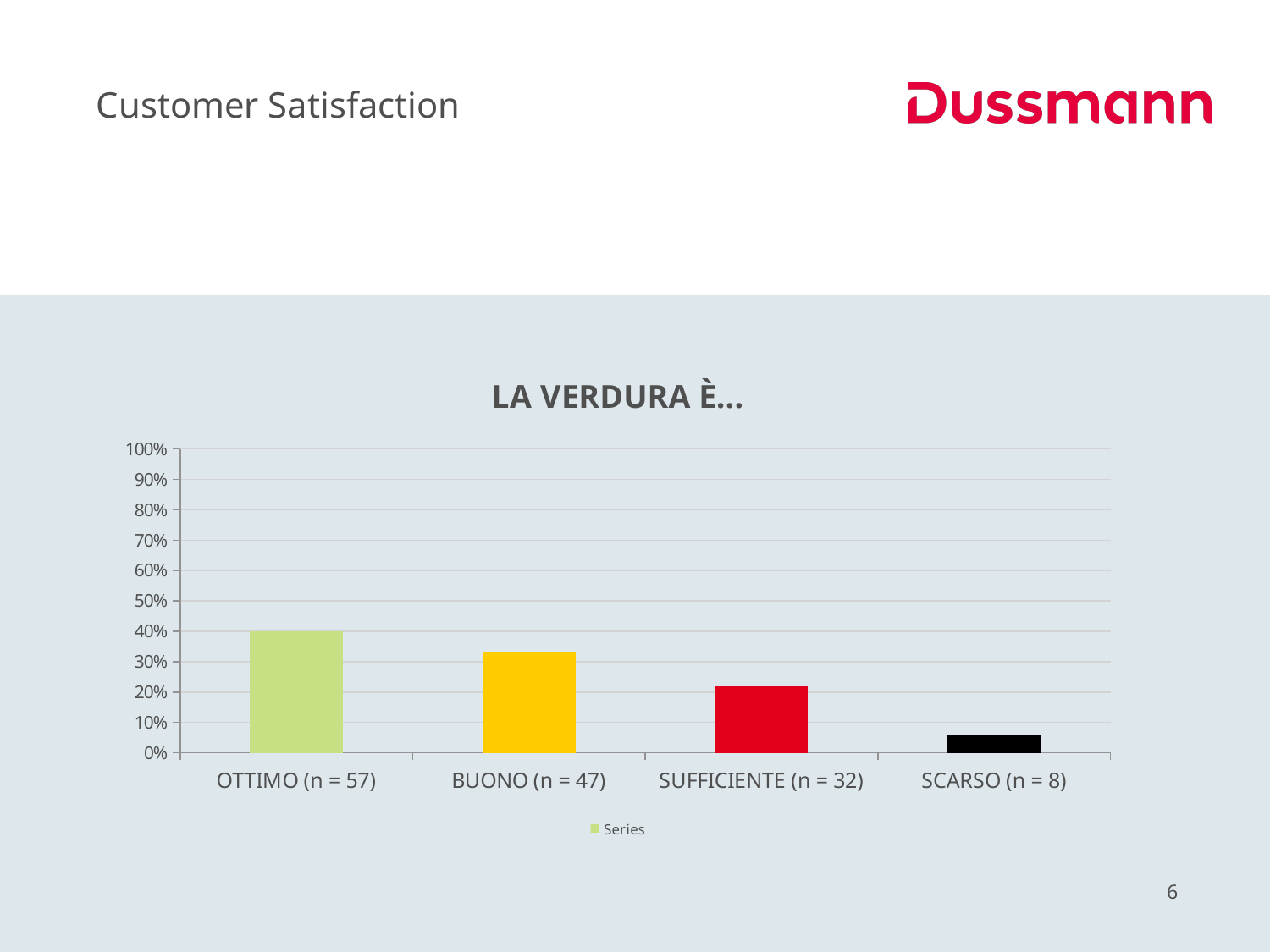
Which category has the lowest bar? SCARSO (n = 8) Is the value for BUONO (n = 47) greater or less than 30%? greater How many categories are shown on the x axis of the chart? 4 What kind of chart is shown on the slide? bar chart Is the value for SCARSO (n = 8) greater or less than 10%? less Do the bar values rise or fall from left to right along the x axis? fall How many series does the legend list? 1 What colour is the bar for SUFFICIENTE (n = 32)? red Which category has the highest bar? OTTIMO (n = 57) What is the title of the chart? LA VERDURA È... Which is larger, the value for BUONO (n = 47) or the value for SUFFICIENTE (n = 32)? BUONO (n = 47) Is the value for SUFFICIENTE (n = 32) greater or less than 30%? less